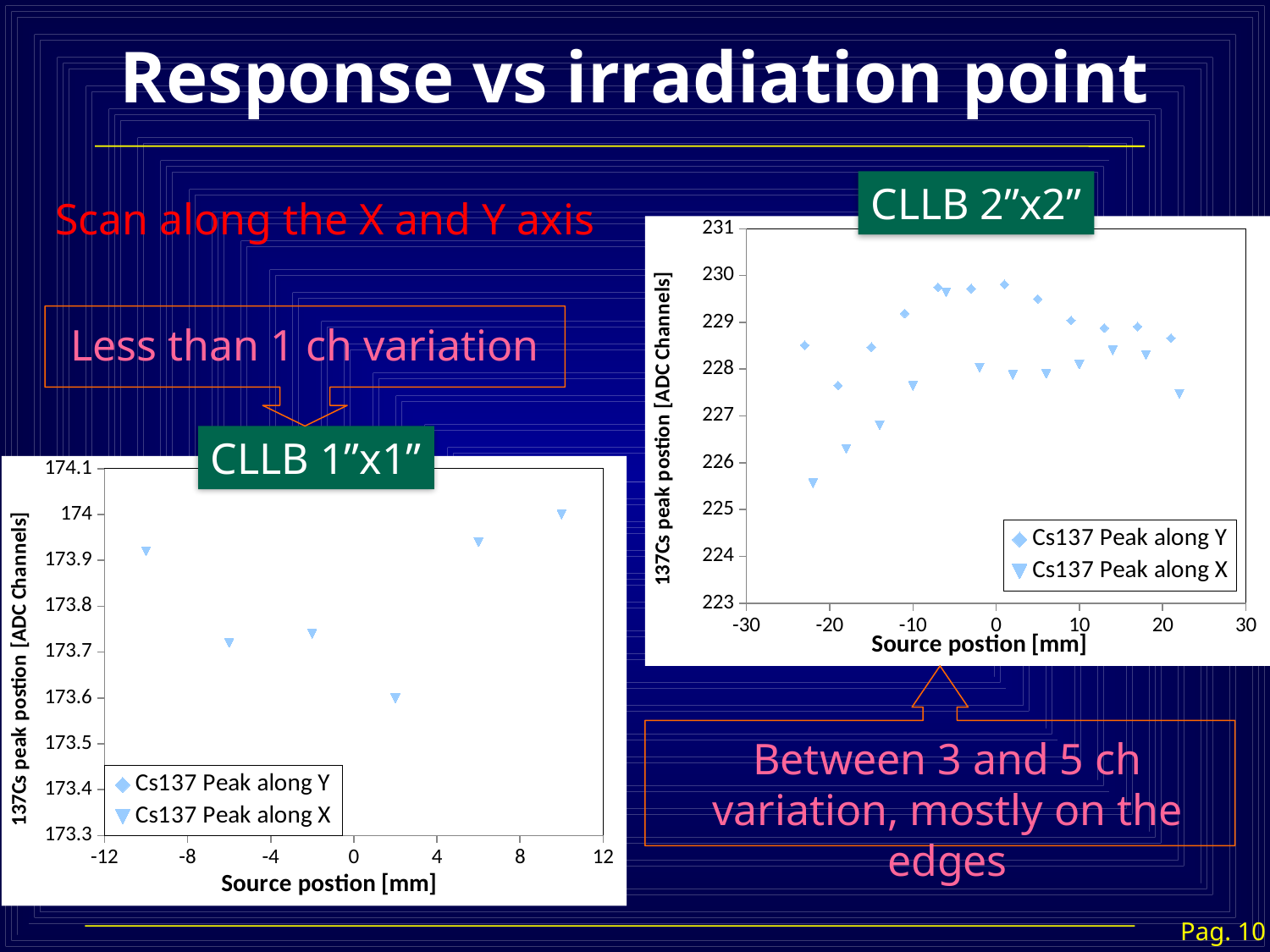
In the CLLB 1"x1" chart, is the value at source position 2 mm greater or less than 173.7? less How many series does the legend of the CLLB 1"x1" chart list? 2 In the CLLB 2"x2" chart, which series contains the lowest plotted point? Cs137 Peak along X How many data points are plotted in the CLLB 1"x1" chart? 6 What kind of chart is the CLLB 1"x1" chart on the left? scatter chart What is the x-axis title of the CLLB 2"x2" chart? Source postion [mm] In the CLLB 2"x2" chart, is the leftmost Cs137 Peak along X value greater or less than 226? less In the CLLB 2"x2" chart, do the Cs137 Peak along X values rise or fall from source position -22 mm to -6 mm? rise How many series does the legend of the CLLB 2"x2" chart list? 2 In the CLLB 2"x2" chart, is the Cs137 Peak along Y value at source position 2 mm greater or less than 229? greater In the CLLB 2"x2" chart, at the leftmost source position, which series has the larger value: Cs137 Peak along Y or Cs137 Peak along X? Cs137 Peak along Y